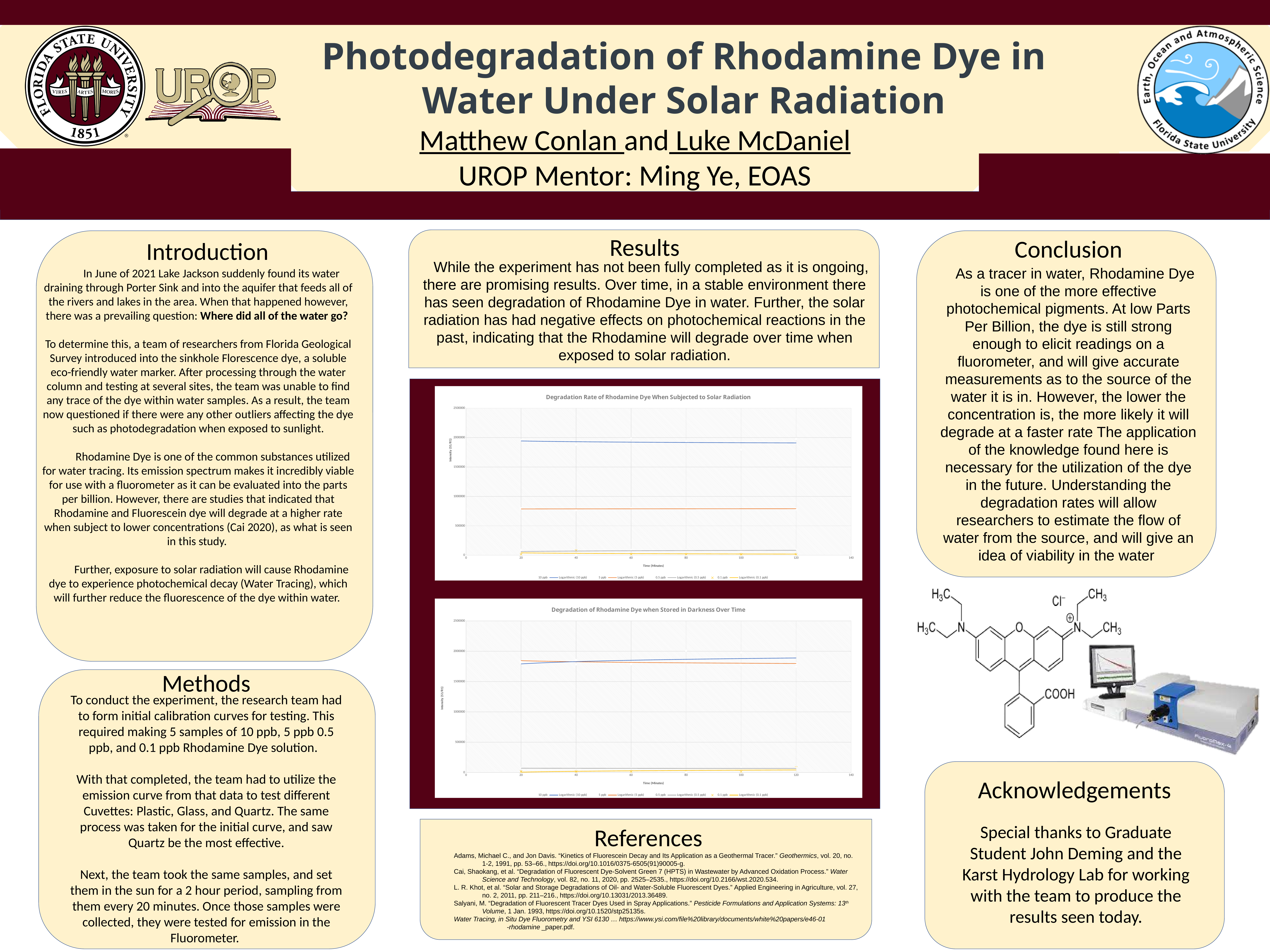
In the bottom chart (stored in darkness), is the intensity for the 5 ppb series greater or less than 1500000? greater How many charts are shown on the slide? 2 In the top chart (solar radiation), is the intensity for the 5 ppb series greater or less than 1000000? less In the top chart (solar radiation), which series has higher intensity, 10 ppb or 5 ppb? 10 ppb What is the title of the bottom chart? Degradation of Rhodamine Dye when Stored in Darkness Over Time In the top chart (solar radiation), which concentration series has the highest intensity values? 10 ppb What is the x-axis label on the top chart (solar radiation)? Time (Minutes) In the top chart (solar radiation), is the intensity for the 10 ppb series greater or less than 1500000? greater What kind of chart is the top chart titled 'Degradation Rate of Rhodamine Dye When Subjected to Solar Radiation'? line chart